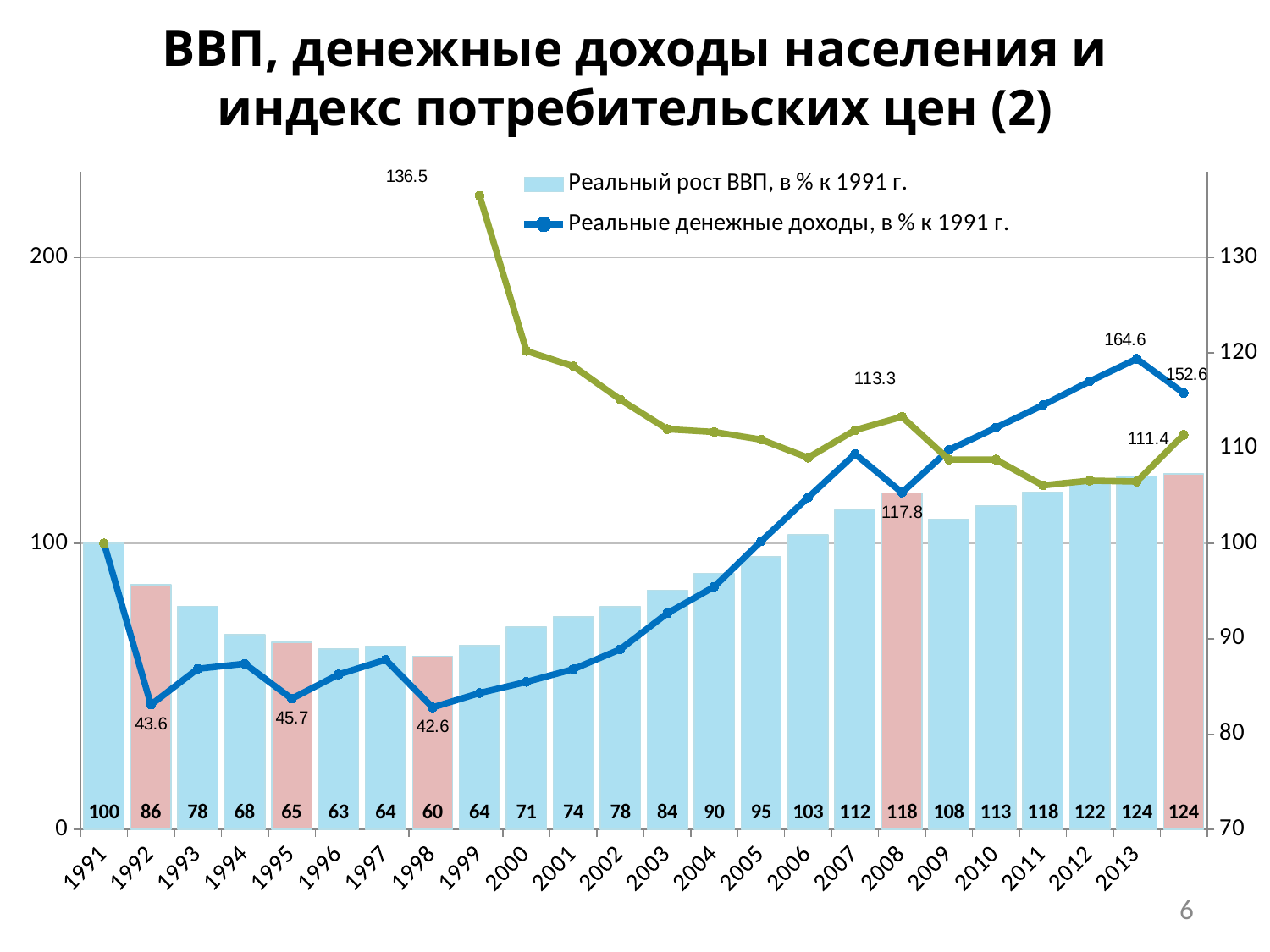
Is the value of the Реальные денежные доходы line for 2007 greater or less than 100 on the left axis? greater What is the value of the bar for 1998 (Реальный рост ВВП)? 60 What kind of chart is shown on the slide? Combined bar and line chart What is the labelled value of the Реальные денежные доходы line for 2013? 164.6 Which year has the lowest bar for Реальный рост ВВП? 1998 How many series does the legend list? 2 What is the labelled value of the Реальные денежные доходы line for 1992? 43.6 How many bars are plotted in the chart? 24 What is the difference between the bar values for 2008 and 2009? 10 Do the bar values rise or fall from 1991 to 1998? fall Which bar is larger, 2000 or 2001? 2001 What is the value of the bar for 2008 (Реальный рост ВВП)? 118